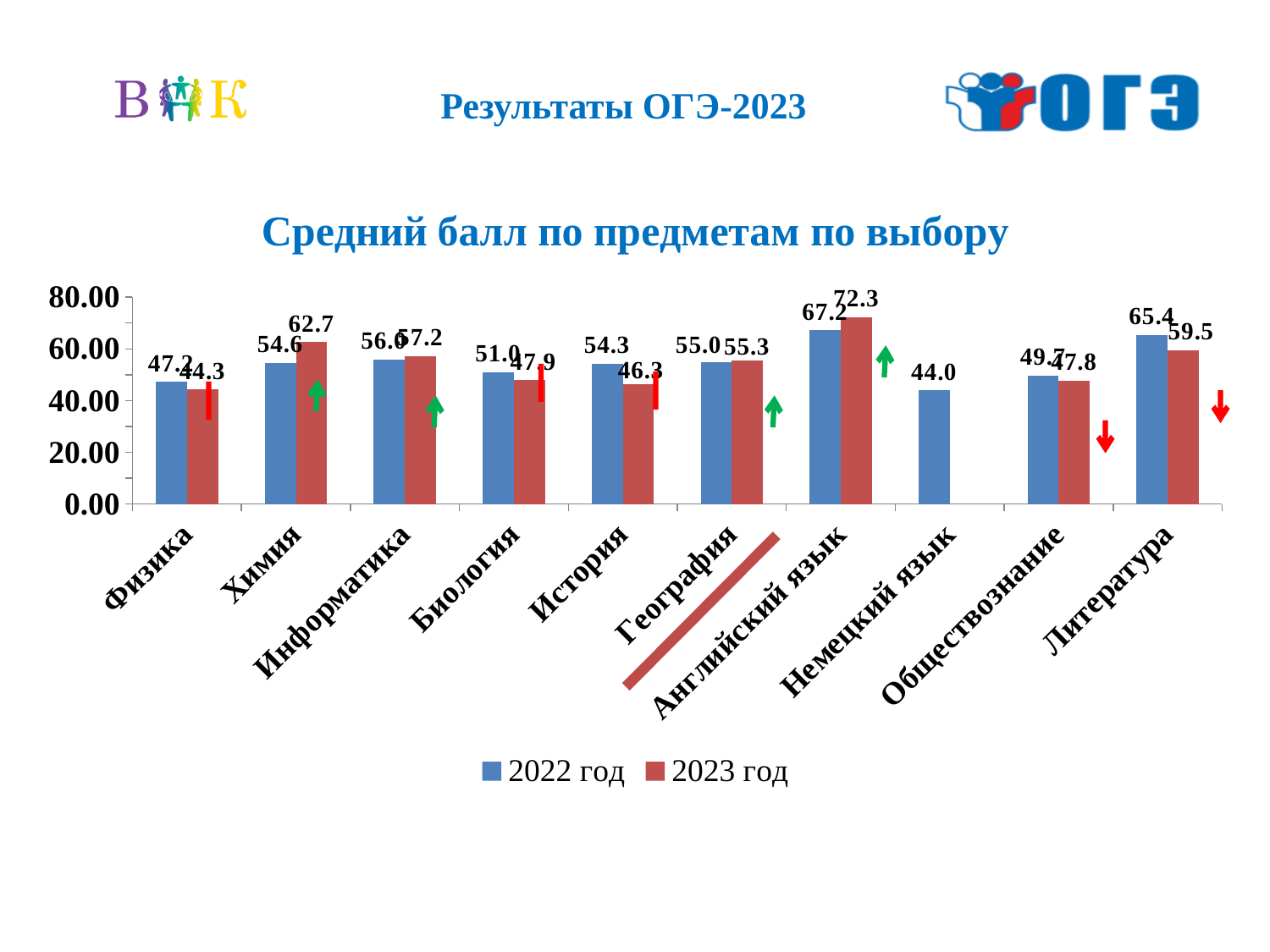
What is the value for Английский язык in the 2022 год series? 67.2 What is the value for Немецкий язык in the 2022 год series? 44.0 Which subject has the highest value in the 2023 год series? Английский язык What kind of chart is shown on the slide? bar chart For Литература, which series has the larger value, 2022 год or 2023 год? 2022 год What is the difference between the 2022 год and 2023 год values for Литература? 5.9 By how much did the value for Химия increase from 2022 год to 2023 год? 8.1 Which subject has the lowest value in the 2022 год series? Немецкий язык How many series does the legend list? 2 Is the 2023 год value for Английский язык greater or less than 60? greater What is the value for Химия in the 2023 год series? 62.7 How many subjects are shown on the x axis of the chart? 10